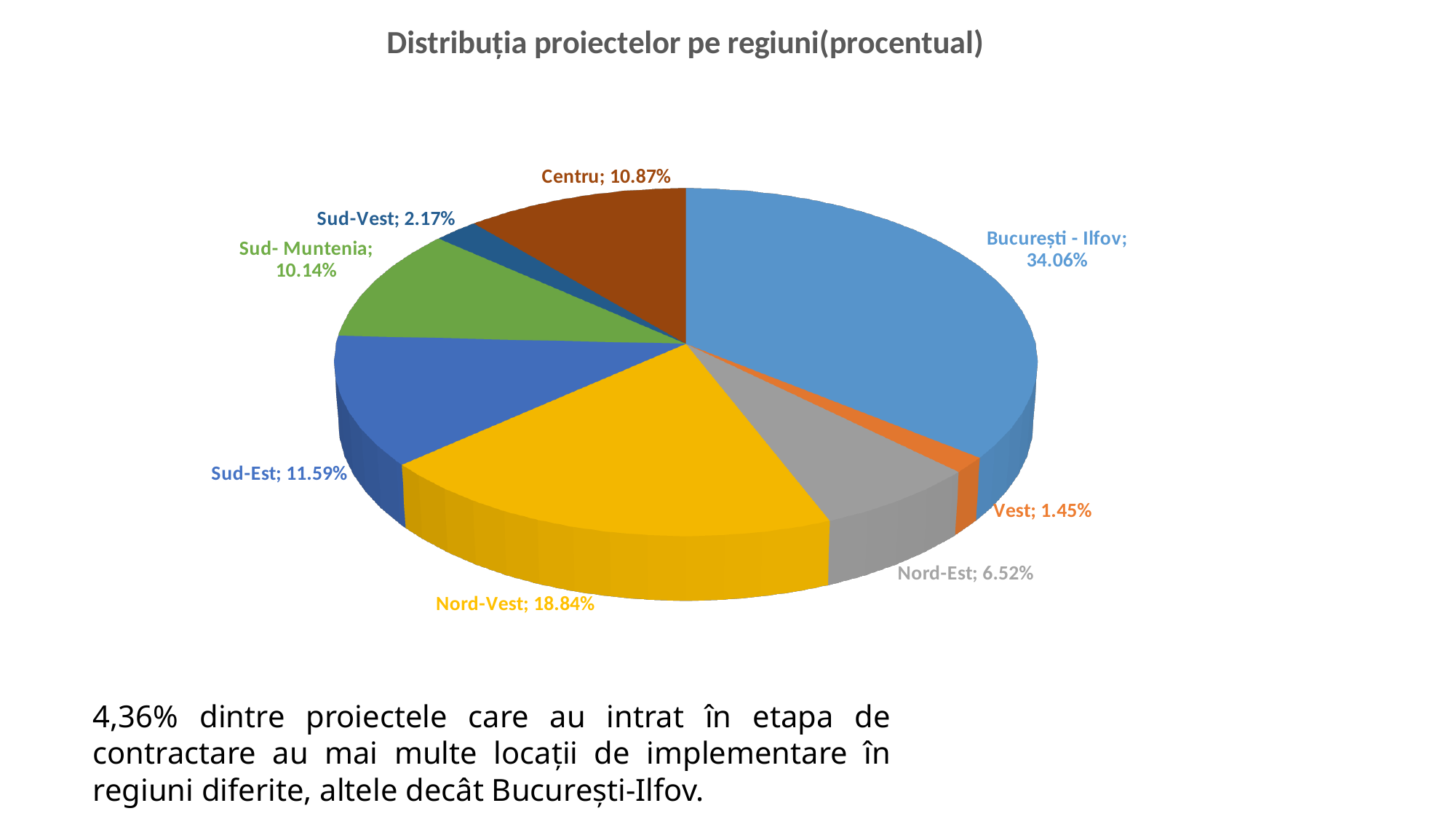
Which region has the largest share of projects? București - Ilfov What percentage of projects is in the Sud-Est region? 11.59% What type of chart is shown on the slide? Pie chart How many regions are shown in the pie chart? 8 What is the title of the chart? Distribuția proiectelor pe regiuni(procentual) Which has a larger share, Centru or Sud- Muntenia? Centru What percentage of projects is in the Nord-Vest region? 18.84% What is the difference in percentage points between Nord-Vest and Nord-Est? 12.32% What percentage of projects is in the Vest region? 1.45% What percentage of projects is in the București - Ilfov region? 34.06% Which region has the smallest share of projects? Vest What colour is the slice for Nord-Vest? Yellow